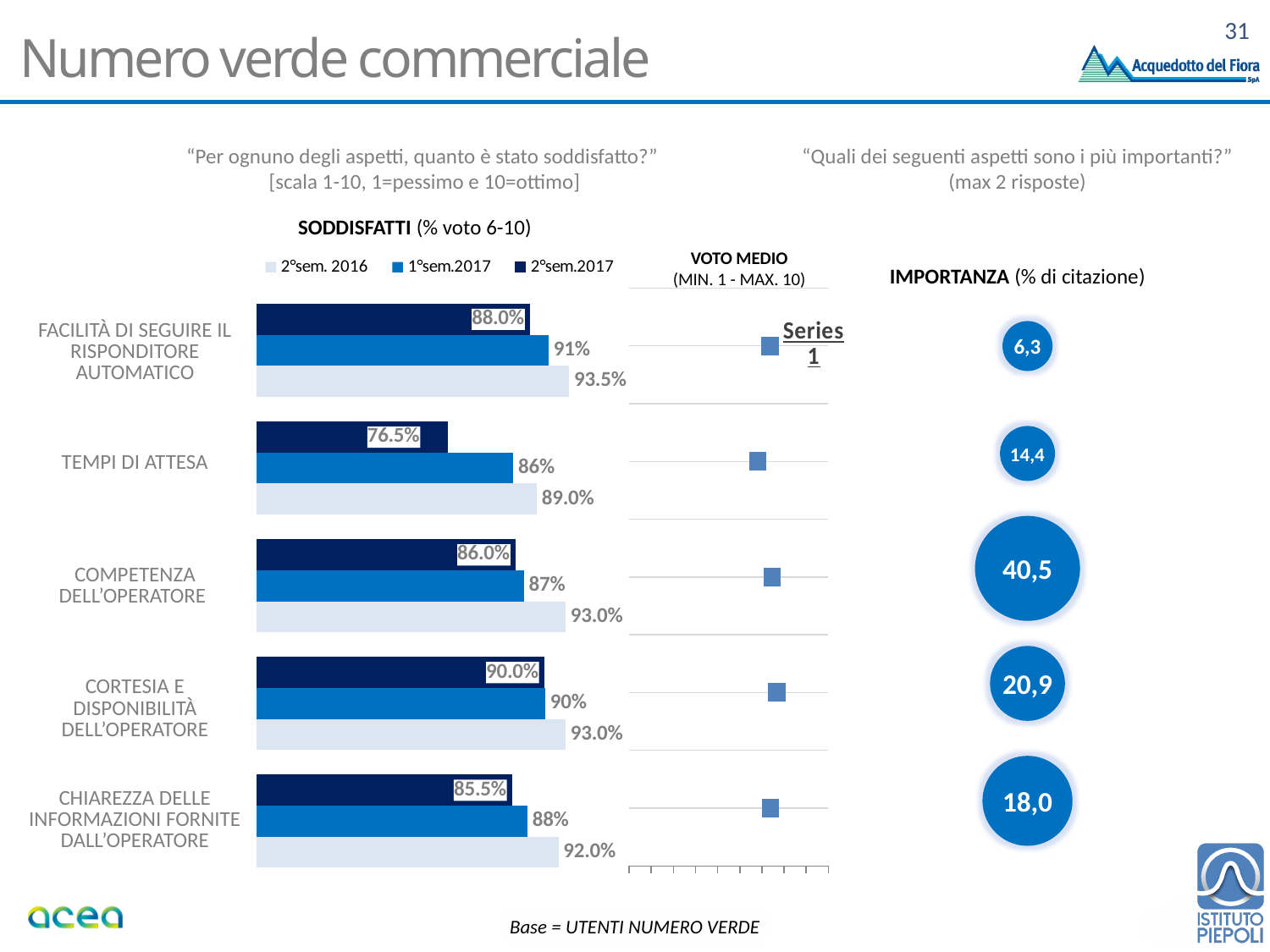
In the SODDISFATTI chart, which category has the lowest 2°sem.2017 value? TEMPI DI ATTESA How many categories are shown in the SODDISFATTI chart? 5 In the SODDISFATTI chart, which category has the highest 2°sem.2017 value? CORTESIA E DISPONIBILITÀ DELL'OPERATORE How many series does the legend of the SODDISFATTI chart list? 3 In the SODDISFATTI chart, what is the difference between the 2°sem. 2016 and 2°sem.2017 values for TEMPI DI ATTESA? 12.5 percentage points What kind of chart is the SODDISFATTI chart? Bar chart In the IMPORTANZA (% di citazione) chart, what is the value for CORTESIA E DISPONIBILITÀ DELL'OPERATORE? 20,9 In the SODDISFATTI chart, what is the 1°sem.2017 value for CHIAREZZA DELLE INFORMAZIONI FORNITE DALL'OPERATORE? 88% In the SODDISFATTI chart, what is the 2°sem.2017 value for TEMPI DI ATTESA? 76.5% In the SODDISFATTI chart, which is larger for COMPETENZA DELL'OPERATORE: the 2°sem. 2016 value or the 1°sem.2017 value? 2°sem. 2016 In the IMPORTANZA (% di citazione) chart, which aspect has the highest value? COMPETENZA DELL'OPERATORE In the SODDISFATTI chart, what is the 2°sem. 2016 value for FACILITÀ DI SEGUIRE IL RISPONDITORE AUTOMATICO? 93.5%